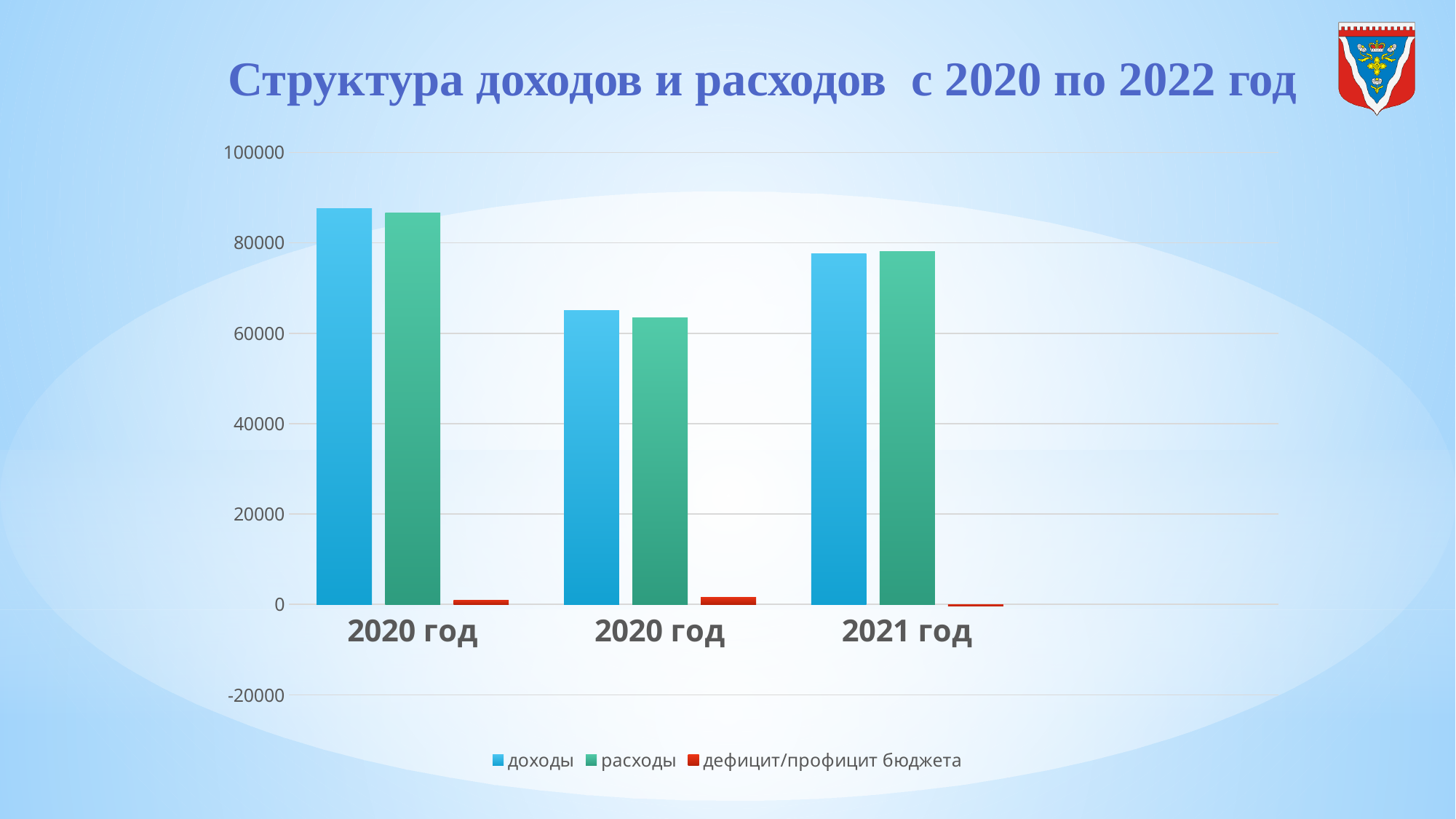
Is the value of расходы in the leftmost group greater or less than 80000? greater Which is larger: доходы in the leftmost group or доходы in the middle group? доходы in the leftmost group Which group has the highest доходы bar? the leftmost 2020 год group Is the value of доходы for 2021 год greater or less than 60000? greater Which group has the lowest расходы bar? the middle 2020 год group What colour represents the series дефицит/профицит бюджета in the legend? red How many series does the legend list? 3 How many category groups are shown along the x axis? 3 Is the value of расходы in the middle group (second "2020 год") greater or less than 60000? greater What kind of chart is shown on the slide? bar chart